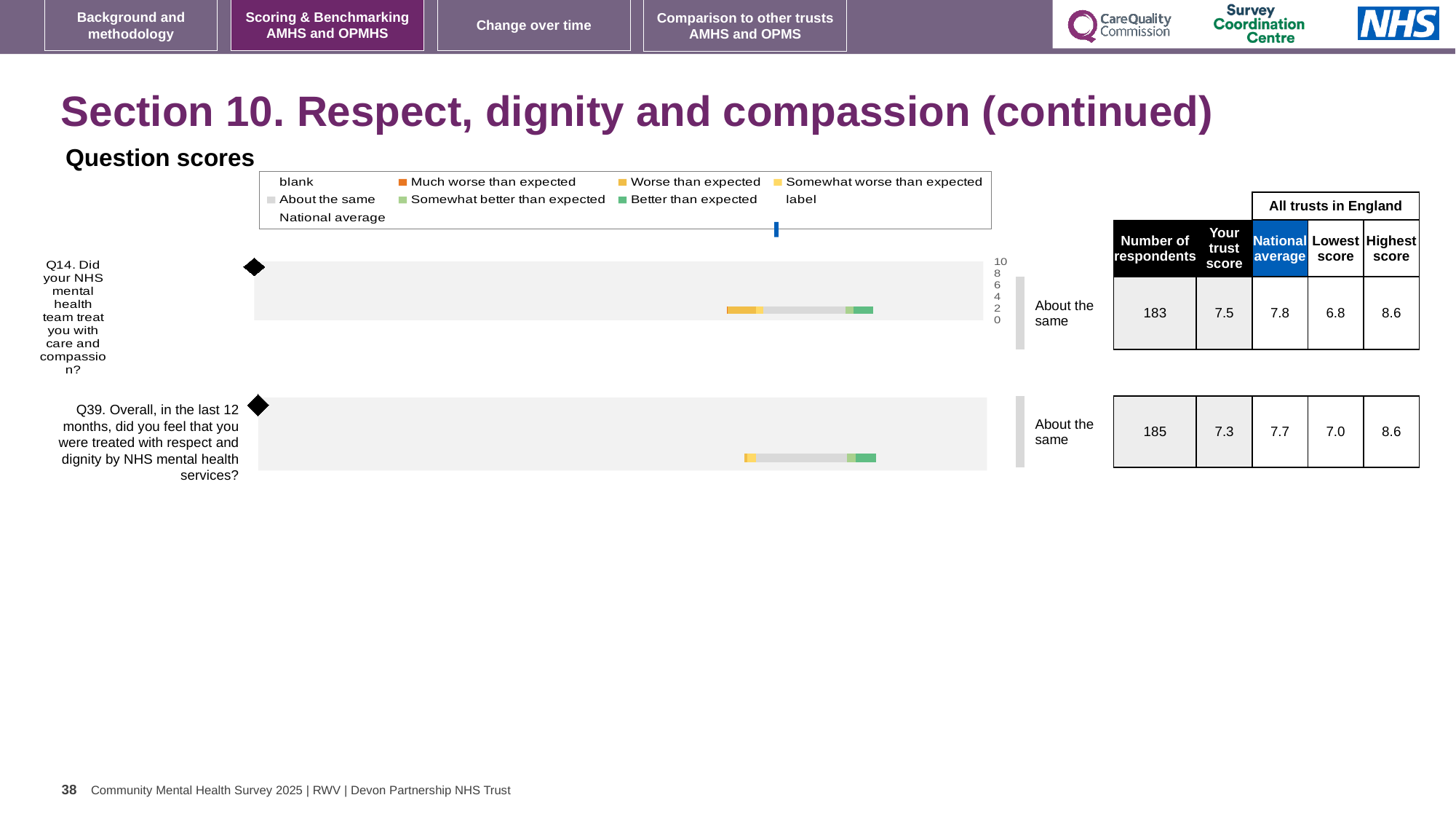
What benchmark category is shown next to the bar for Q39? About the same Which question has the higher trust score, Q14 or Q39? Q14 What is the national average for Q14 in the question scores table? 7.8 How many questions are plotted in the question scores chart? 2 What is the number of respondents for Q14 in the question scores table? 183 What is the lowest score across all trusts in England for Q39? 7.0 What is the difference between the number of respondents for Q39 and Q14? 2 What kind of chart is used to show the question scores on this slide? bar chart What is the difference between the national average and the trust score for Q14? 0.3 What is the trust score for Q39 in the question scores table? 7.3 What is the highest score across all trusts in England for Q14? 8.6 What is the title of the chart on this slide? Question scores